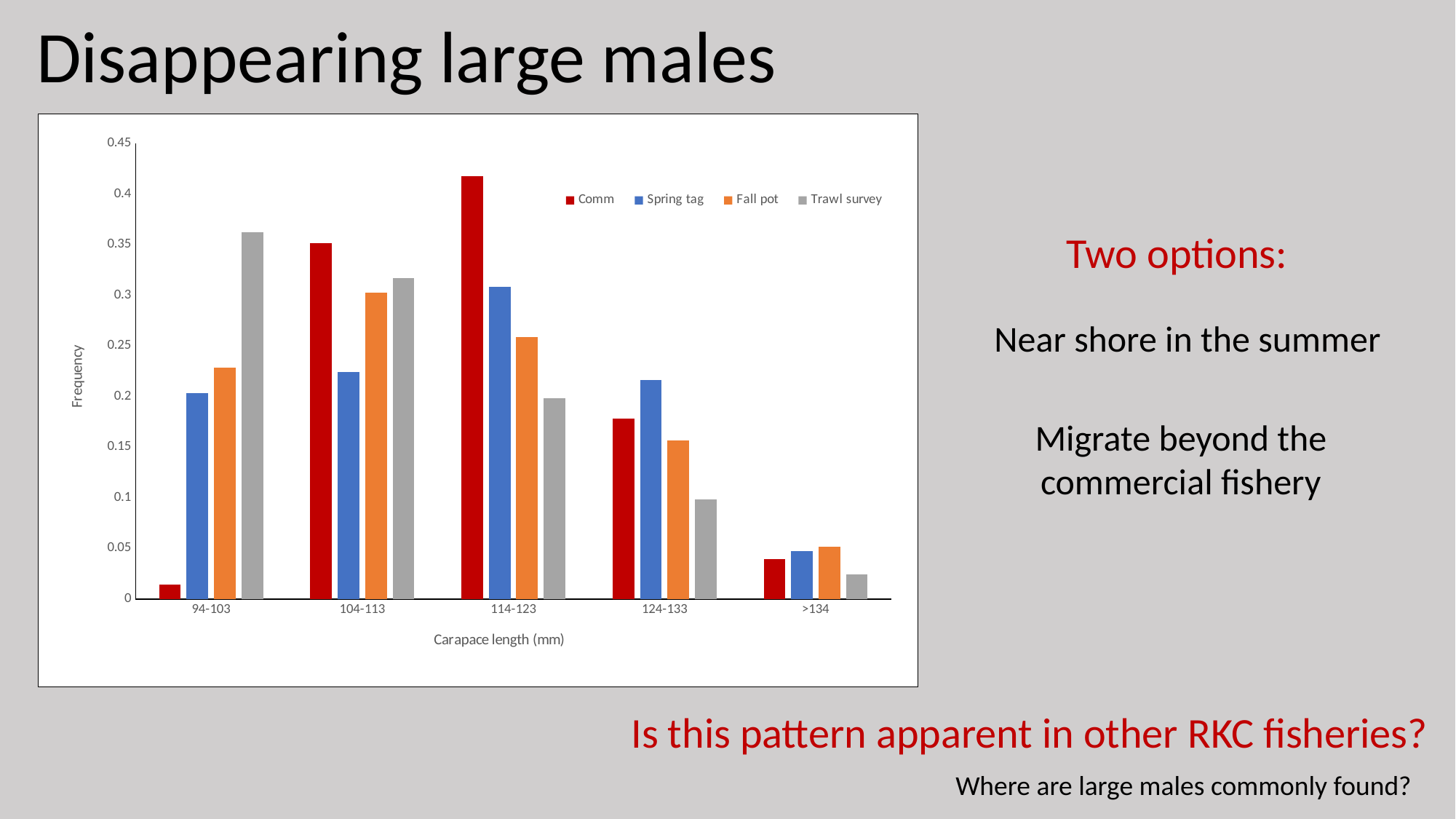
How many carapace length categories are shown on the x axis? 5 Do the Trawl survey values rise or fall as carapace length increases along the x axis? Fall In which carapace length category is the Comm series lowest? 94-103 Is the Fall pot value for 124-133 greater or less than 0.2? less In which carapace length category is the Trawl survey series highest? 94-103 For the 94-103 category, which is larger: Comm or Trawl survey? Trawl survey How many series does the legend list? 4 What kind of chart is shown on the slide? Bar chart For the 124-133 category, which is larger: Spring tag or Comm? Spring tag Is the Comm value for 114-123 greater or less than 0.4? greater In which carapace length category is the Comm series highest? 114-123 Is the Trawl survey value for 94-103 greater or less than 0.3? greater